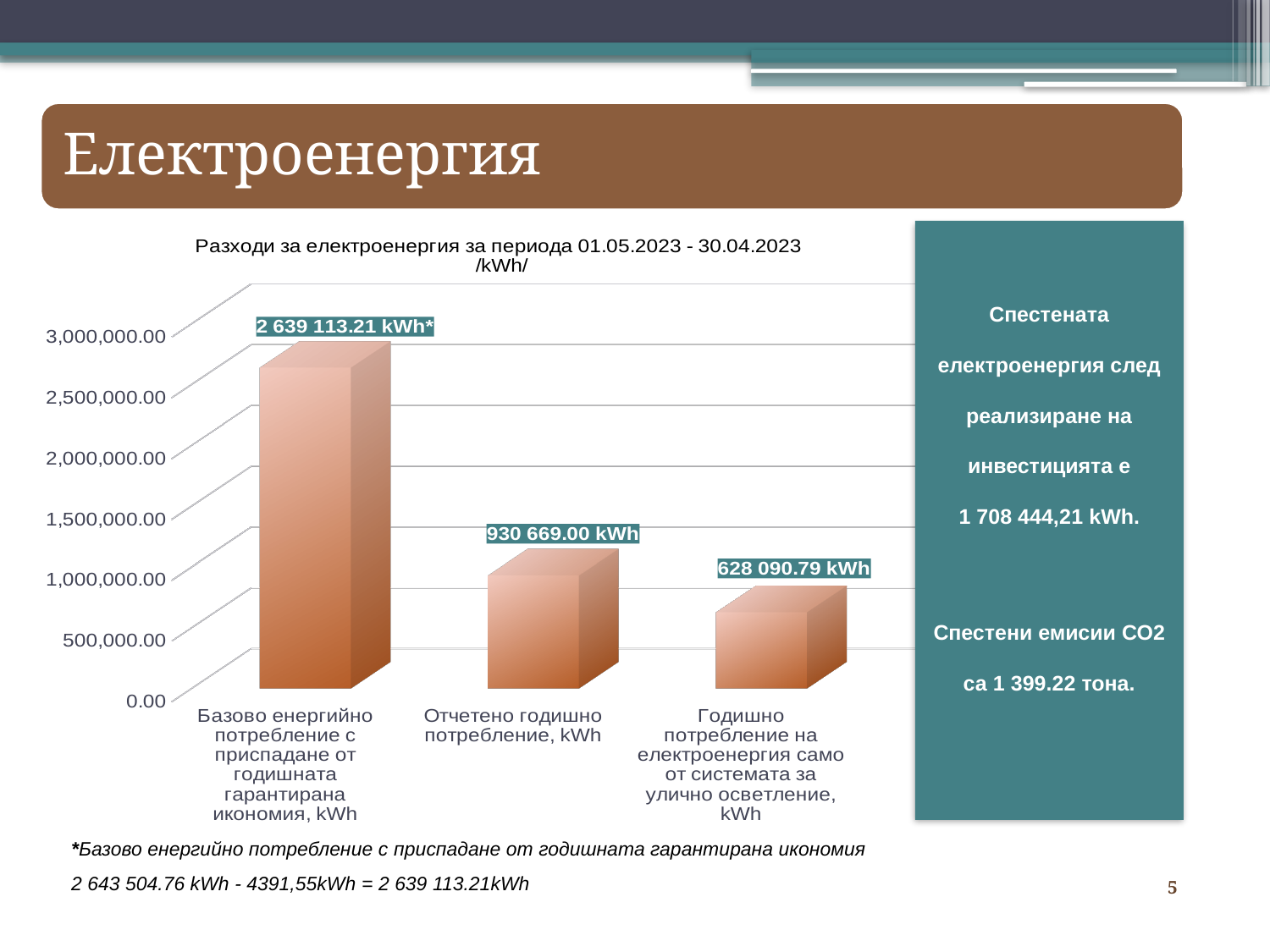
What type of chart is shown on the slide? bar chart Do the values rise or fall from left to right along the x axis? fall Which category has the lowest value? Годишно потребление на електроенергия само от системата за улично осветление, kWh What is the value for "Базово енергийно потребление с приспадане от годишната гарантирана икономия, kWh"? 2 639 113.21 kWh* How many bars (categories) does the chart show? 3 What is the value for "Годишно потребление на електроенергия само от системата за улично осветление, kWh"? 628 090.79 kWh What is the difference between "Базово енергийно потребление с приспадане от годишната гарантирана икономия, kWh" and "Отчетено годишно потребление, kWh"? 1 708 444.21 kWh Which category has the highest value? Базово енергийно потребление с приспадане от годишната гарантирана икономия, kWh Which is larger: "Отчетено годишно потребление, kWh" or "Годишно потребление на електроенергия само от системата за улично осветление, kWh"? Отчетено годишно потребление, kWh What is the value for "Отчетено годишно потребление, kWh"? 930 669.00 kWh What is the difference between "Отчетено годишно потребление, kWh" and "Годишно потребление на електроенергия само от системата за улично осветление, kWh"? 302 578.21 kWh What is the title of the chart? Разходи за електроенергия за периода 01.05.2023 - 30.04.2023 /kWh/